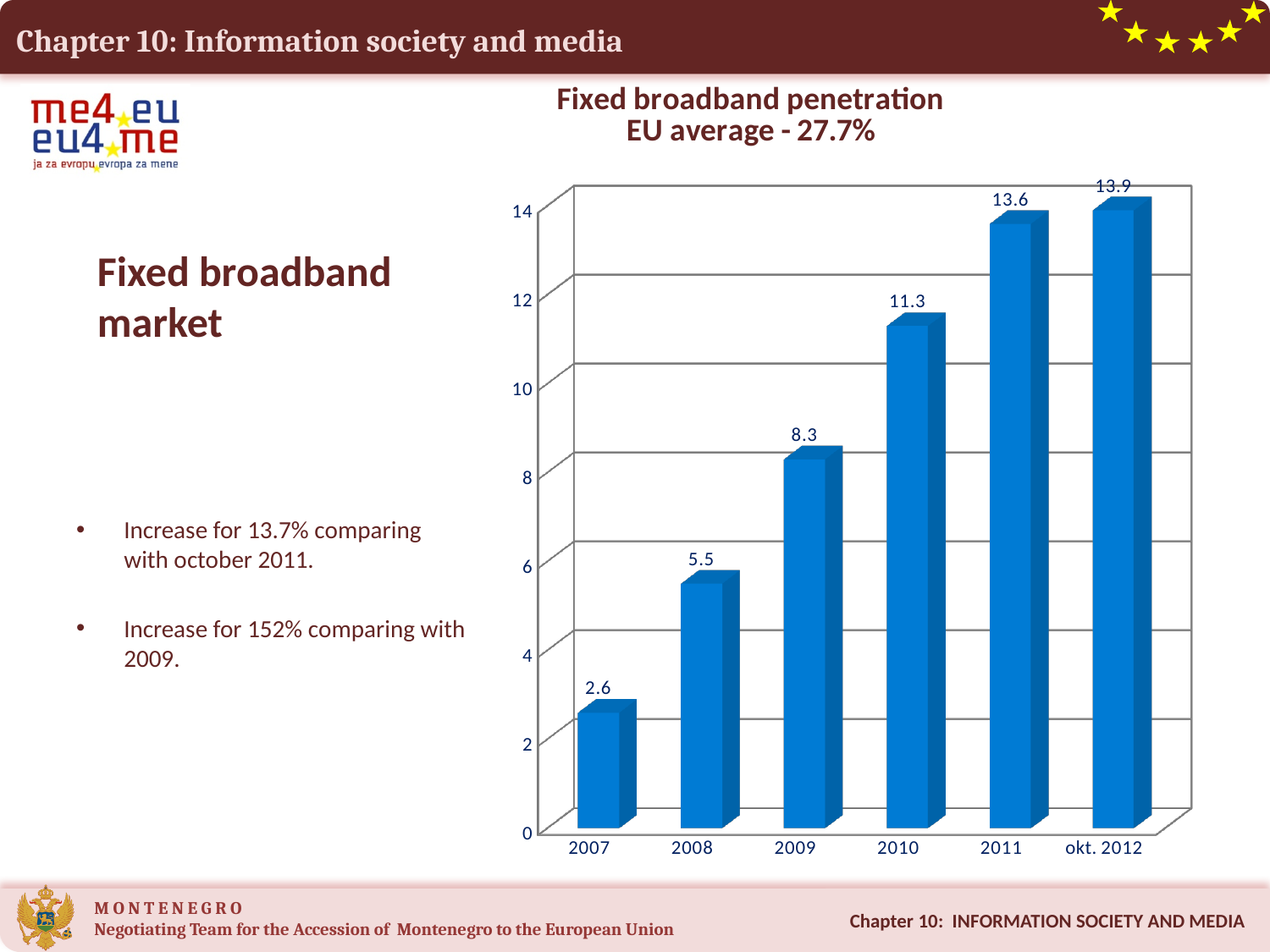
Which category has the highest fixed broadband penetration? okt. 2012 How many categories are shown on the x axis of the chart? 6 What is the value shown for 2007? 2.6 What is the difference between the values for 2010 and 2009? 3 What kind of chart is shown on the slide? bar chart What is the fixed broadband penetration value for 2009? 8.3 Which is larger, the value for 2010 or the value for 2008? 2010 Do the values rise or fall from 2007 to okt. 2012? rise What is the difference between the values for 2008 and 2007? 2.9 Is the value for 2011 greater or less than 12? greater What is the fixed broadband penetration value for okt. 2012? 13.9 Which year has the lowest fixed broadband penetration? 2007